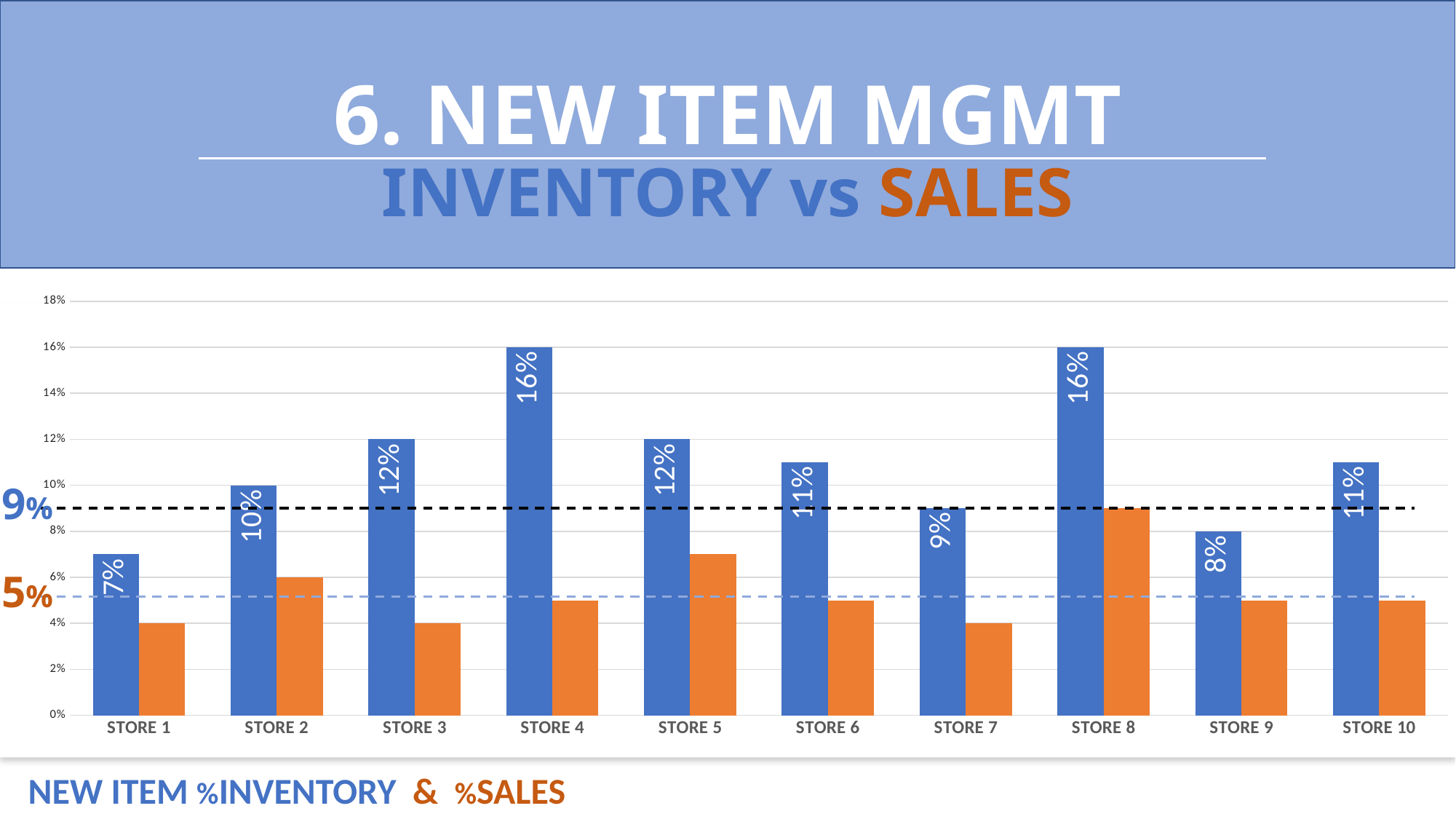
What kind of chart is shown on the slide? Bar chart What colour are the bars representing new item %sales? Orange What is the difference between the %inventory values for Store 3 and Store 1? 5% What is the new item %inventory value for Store 4? 16% Is the %sales value for Store 5 greater or less than 6%? greater What is the difference between the %inventory values for Store 8 and Store 9? 8% Which has a higher %inventory value, Store 6 or Store 9? Store 6 What is the new item %inventory value for Store 2? 10% Which store has the lowest new item %inventory? Store 1 What is the new item %inventory value for Store 7? 9% Is the %sales value for Store 8 greater or less than 8%? greater How many stores are shown on the x axis of the chart? 10